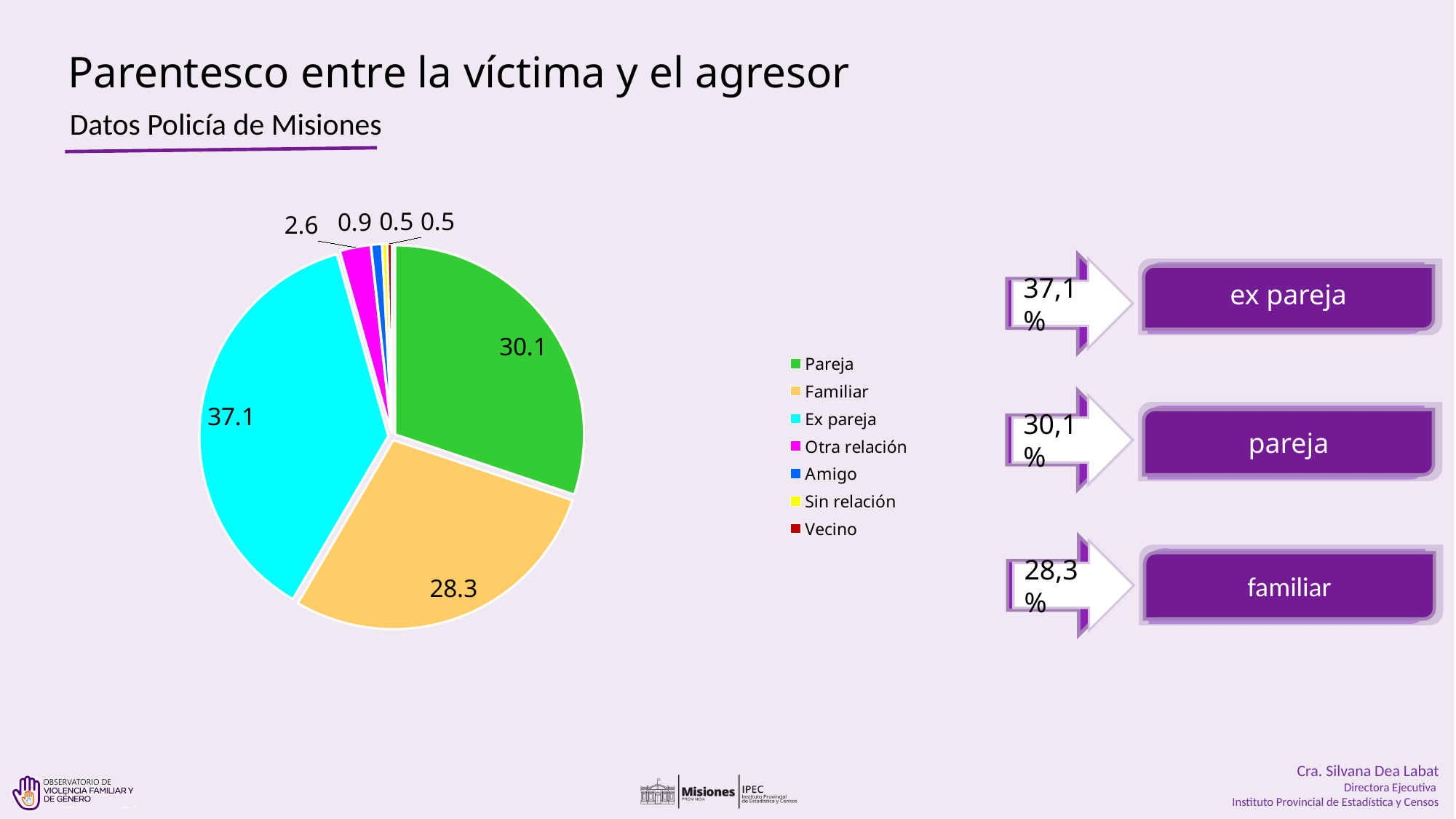
What value is shown for the Ex pareja slice of the pie chart? 37.1 What type of chart is shown on the slide? Pie chart What value is shown for the Amigo slice of the pie chart? 0.9 How many categories does the pie chart legend list? 7 What is the difference between the Ex pareja value and the Pareja value in the pie chart? 7.0 What share of the pie does the Pareja slice represent? 30.1 Which is larger in the pie chart, the Otra relación slice or the Amigo slice? Otra relación What value is shown for the Otra relación slice of the pie chart? 2.6 Which category has the largest slice in the pie chart? Ex pareja What value is shown for the Familiar slice of the pie chart? 28.3 What colour is the Ex pareja slice in the pie chart? Cyan What is the difference between the Pareja value and the Familiar value in the pie chart? 1.8